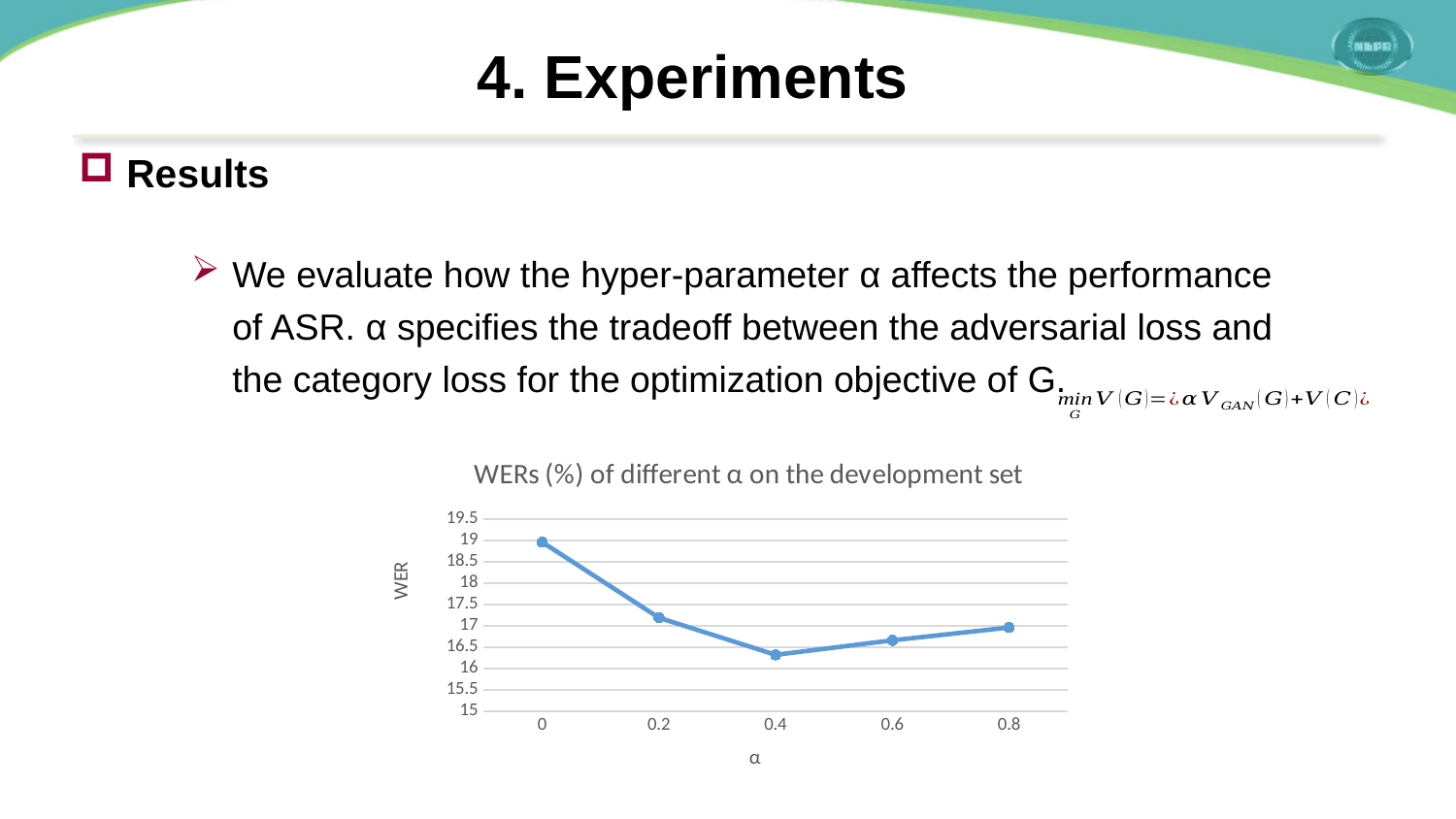
Which has a higher WER, α = 0 or α = 0.8? α = 0 What is the title of the chart? WERs (%) of different α on the development set At which value of α is the WER lowest? 0.4 Which has a higher WER, α = 0.2 or α = 0.4? α = 0.2 At which value of α is the WER highest? 0 Is the WER for α = 0.2 greater or less than 17.5? less How many α values are plotted on the chart? 5 Is the WER for α = 0.4 greater or less than 16.5? less How does the WER change as α increases from 0 to 0.4? it falls What kind of chart is shown on the slide? line chart Is the WER for α = 0.8 greater or less than 17.5? less